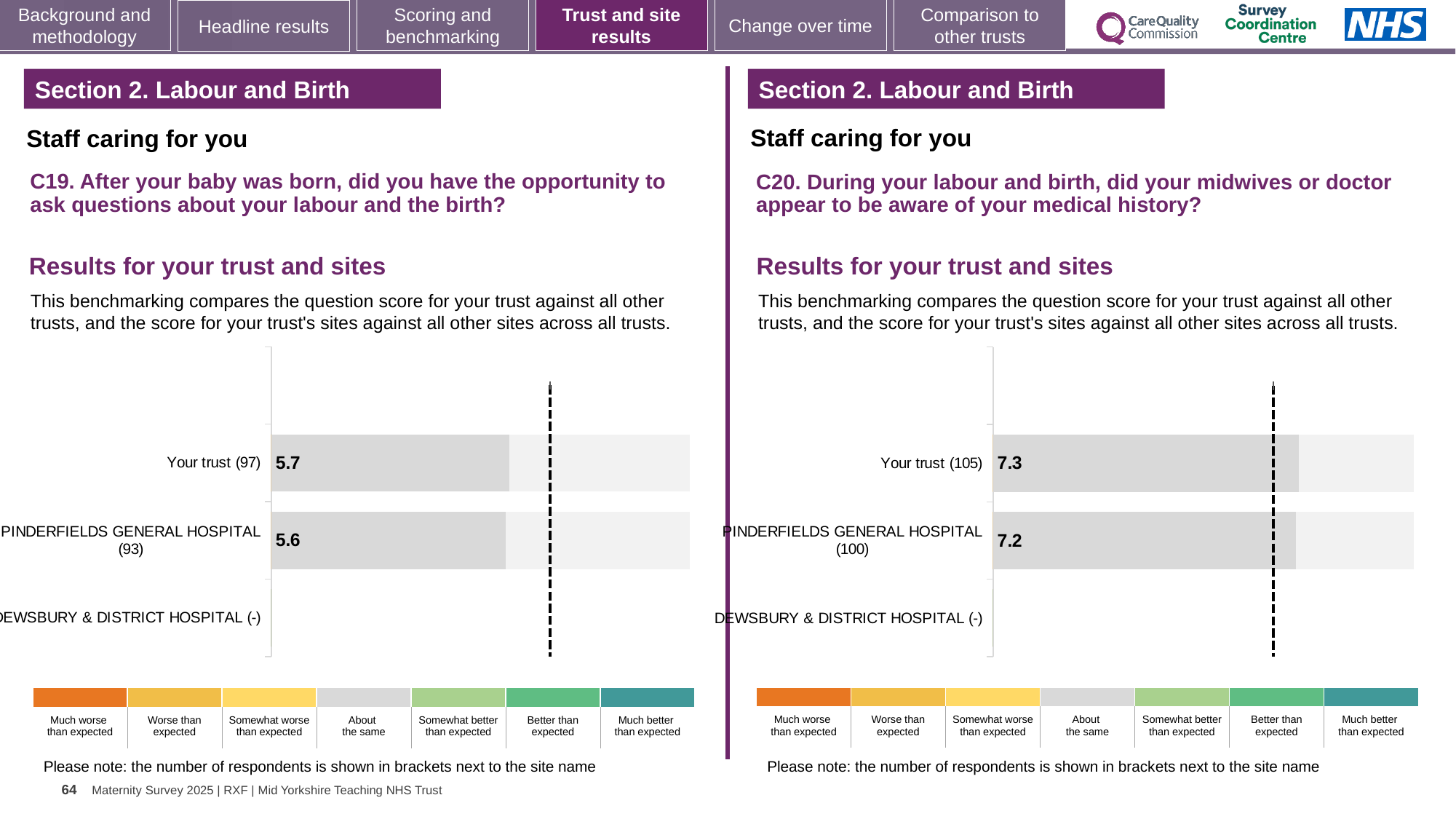
In the C20 chart on the right, which has the higher score, Your trust or Pinderfields General Hospital? Your trust In the C20 chart on the right, how many respondents are shown in brackets for Pinderfields General Hospital? 100 In the C19 chart on the left, what is the score for Your trust? 5.7 In the C20 chart on the right, what is the score for Pinderfields General Hospital? 7.2 In the C20 chart on the right, what is the score for Your trust? 7.3 In the C20 chart on the right, what is the difference between the Your trust score and the Pinderfields General Hospital score? 0.1 How many categories are listed on the vertical axis of the C19 chart on the left? 3 In the C19 chart on the left, how many respondents are shown in brackets for Your trust? 97 What kind of chart is used for the C20 results on the right? Bar chart In the C19 chart on the left, what is the score for Pinderfields General Hospital? 5.6 In the C19 chart on the left, what is the difference between the Your trust score and the Pinderfields General Hospital score? 0.1 In the C19 chart on the left, which site has no score bar shown? Dewsbury & District Hospital